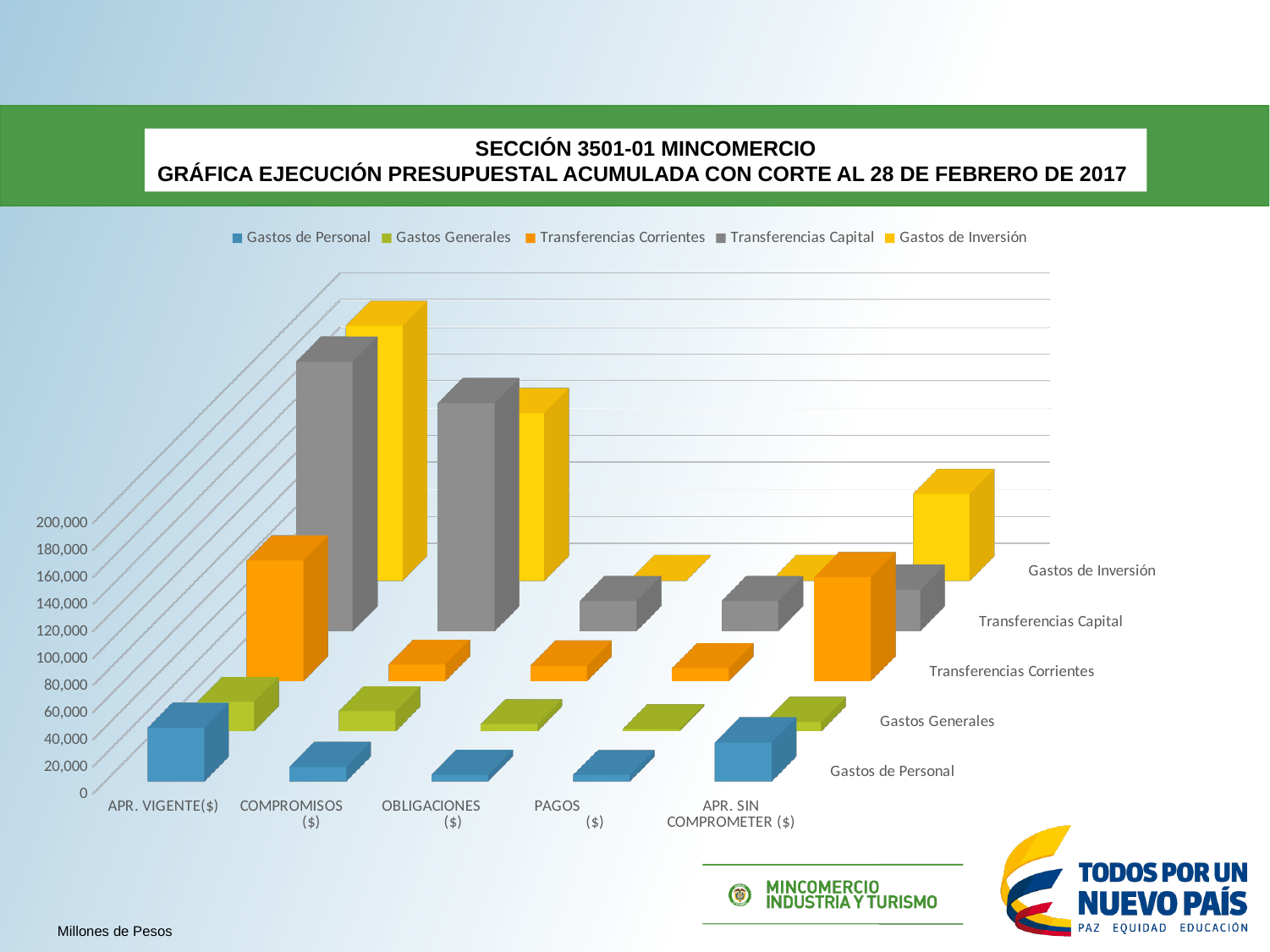
How many categories are shown along the x axis? 5 How many series does the legend list? 5 What unit is indicated at the bottom left of the slide for the chart values? Millones de Pesos For APR. VIGENTE($), which is larger: Transferencias Capital or Gastos de Personal? Transferencias Capital For Gastos de Inversión, which is larger: APR. VIGENTE($) or APR. SIN COMPROMETER ($)? APR. VIGENTE($) What kind of chart is shown on the slide? bar chart Which series has the lowest value for APR. VIGENTE($)? Gastos Generales Which series has the highest value for APR. VIGENTE($)? Transferencias Capital Which series is listed first in the legend? Gastos de Personal